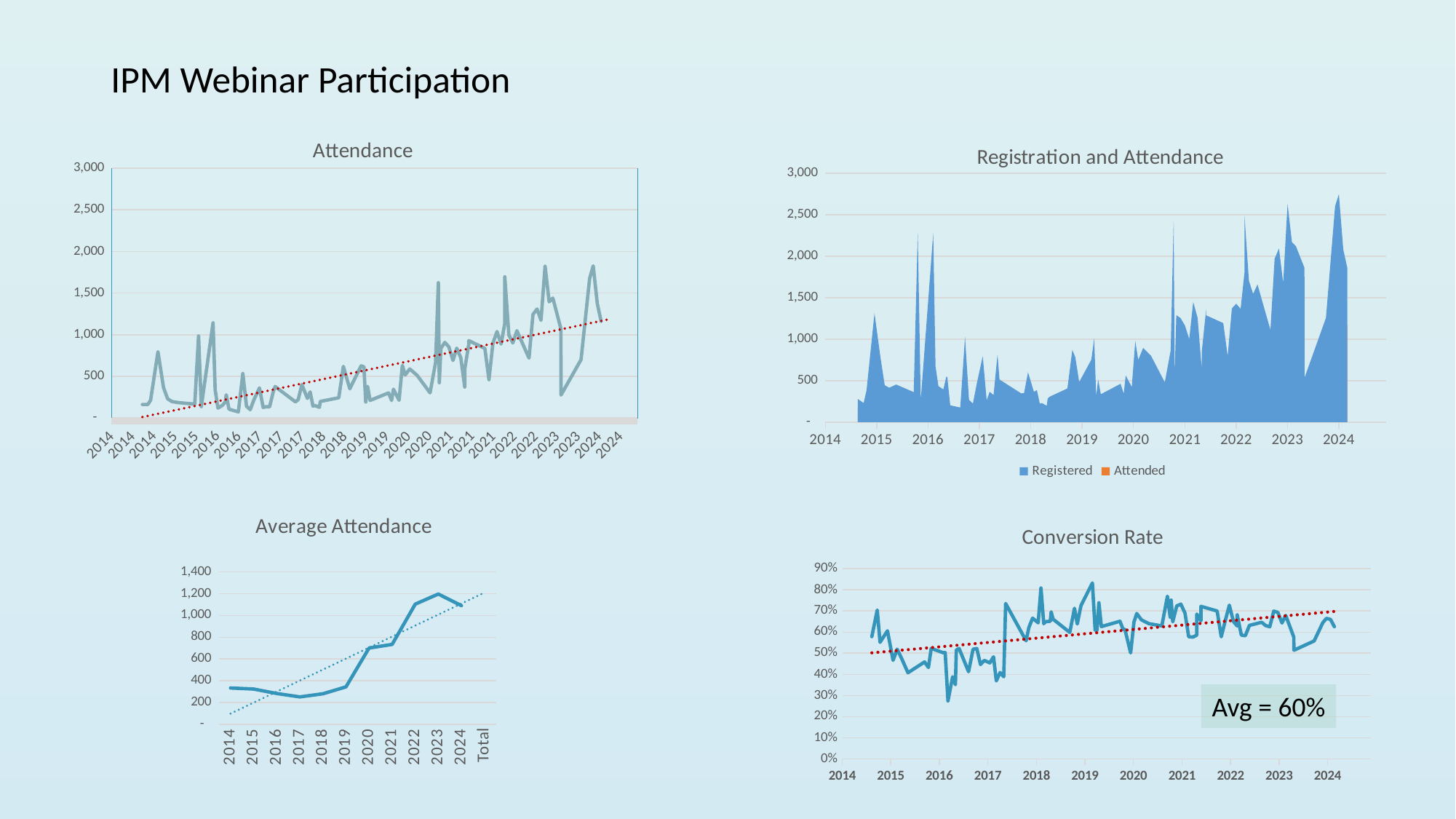
On the Average Attendance chart, is the value for 2017 greater or less than 400? less On the Conversion Rate chart, does the dotted trend line rise or fall from 2014 to 2024? rise What kind of chart is the Registration and Attendance chart at the top right? area chart On the Average Attendance chart, is the value for 2023 greater or less than 1,000? greater What average conversion rate is stated on the Conversion Rate chart? Avg = 60% What are the two legend entries on the Registration and Attendance chart? Registered and Attended On the Average Attendance chart, do the values generally rise or fall from 2017 to 2023? rise On the Average Attendance chart, which is larger, the value for 2015 or the value for 2020? 2020 On the Average Attendance chart, which year has the lowest average attendance? 2017 What kind of chart is the Attendance chart at the top left? line chart On the Average Attendance chart, which year has the highest average attendance? 2023 How many series does the legend of the Registration and Attendance chart list? 2